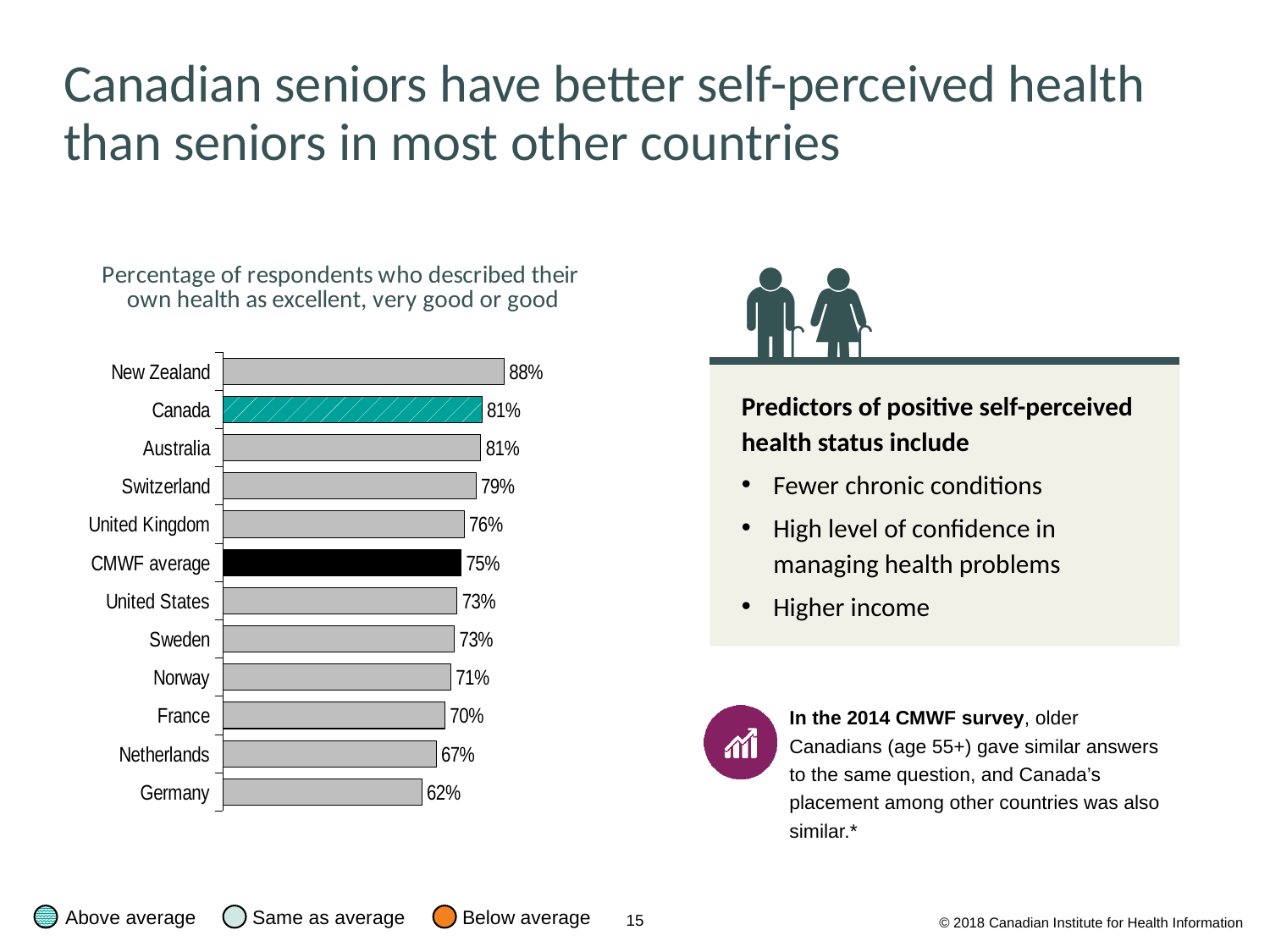
What is the difference between the values for New Zealand and Germany? 26% What is the CMWF average shown in the chart? 75% How many percentage points is Canada above the CMWF average? 6% What is the title of the chart? Percentage of respondents who described their own health as excellent, very good or good What is the value shown for Germany? 62% What type of chart is shown on the slide? Bar chart Which has a higher value, Switzerland or the United Kingdom? Switzerland What is the value shown for Canada in the chart? 81% Which country has the lowest percentage in the chart? Germany Which country has the highest percentage of respondents describing their health as excellent, very good or good? New Zealand What percentage of respondents in New Zealand described their own health as excellent, very good or good? 88% How many bars are shown in the chart, including the CMWF average? 12